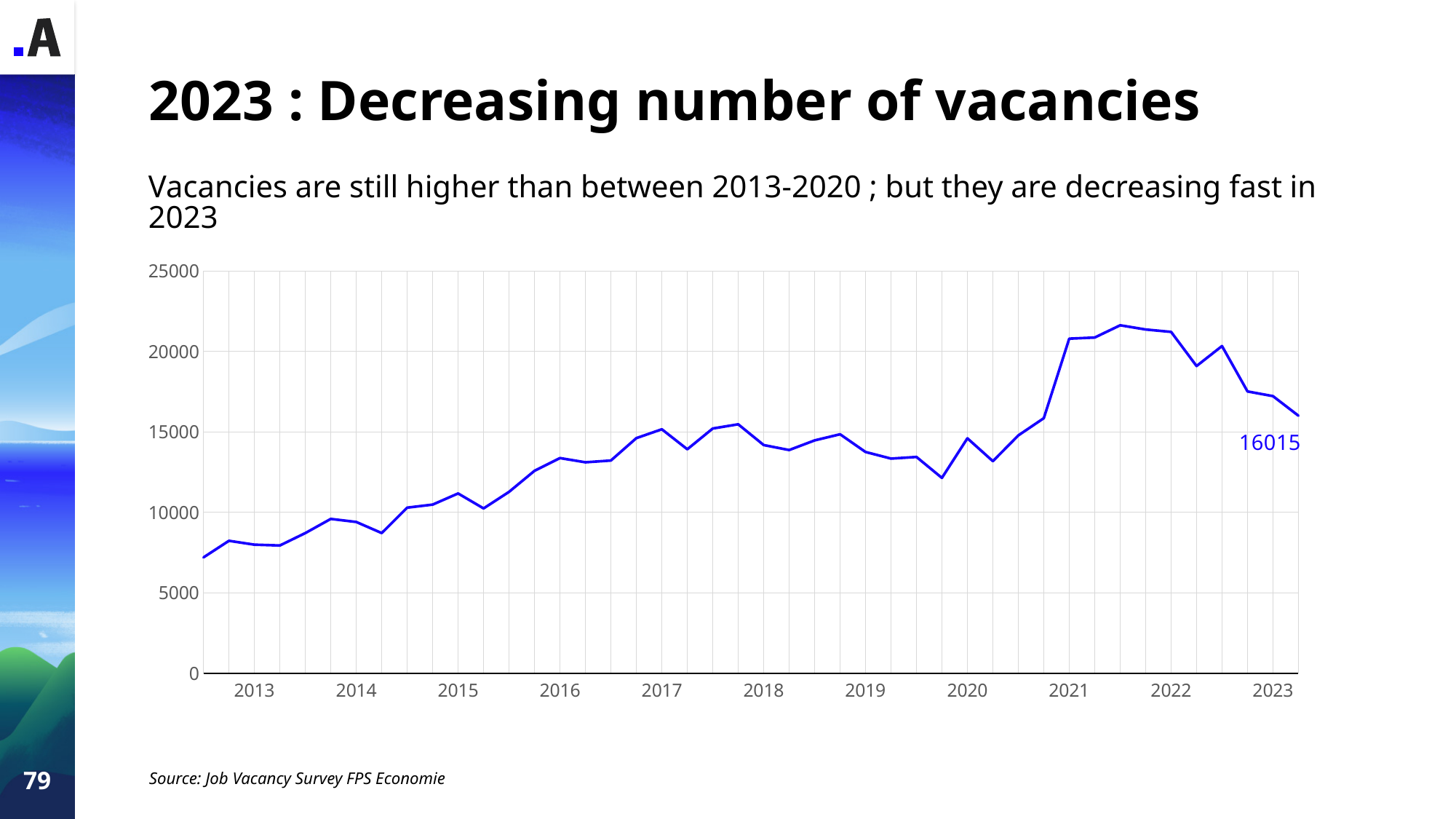
What source is cited below the chart? Job Vacancy Survey FPS Economie What is the value of the last data point in 2023, as labelled on the chart? 16015 Do the values generally rise or fall from 2013 to 2017? rise Which year on the x axis has the lowest value on the line? 2013 What kind of chart is shown on the slide? line chart Is the highest point of the line, around 2021, greater or less than 20000? greater Is the value at the start of 2013 greater or less than 10000? less Is the value at the 2019 tick greater or less than 15000? less How many year labels are shown on the x axis? 11 Which is larger: the value at the start of 2013 or the labelled value at the end of 2023? end of 2023 Do the values rise or fall between the 2021 peak and the end of 2023? fall What is the highest value shown on the y axis? 25000